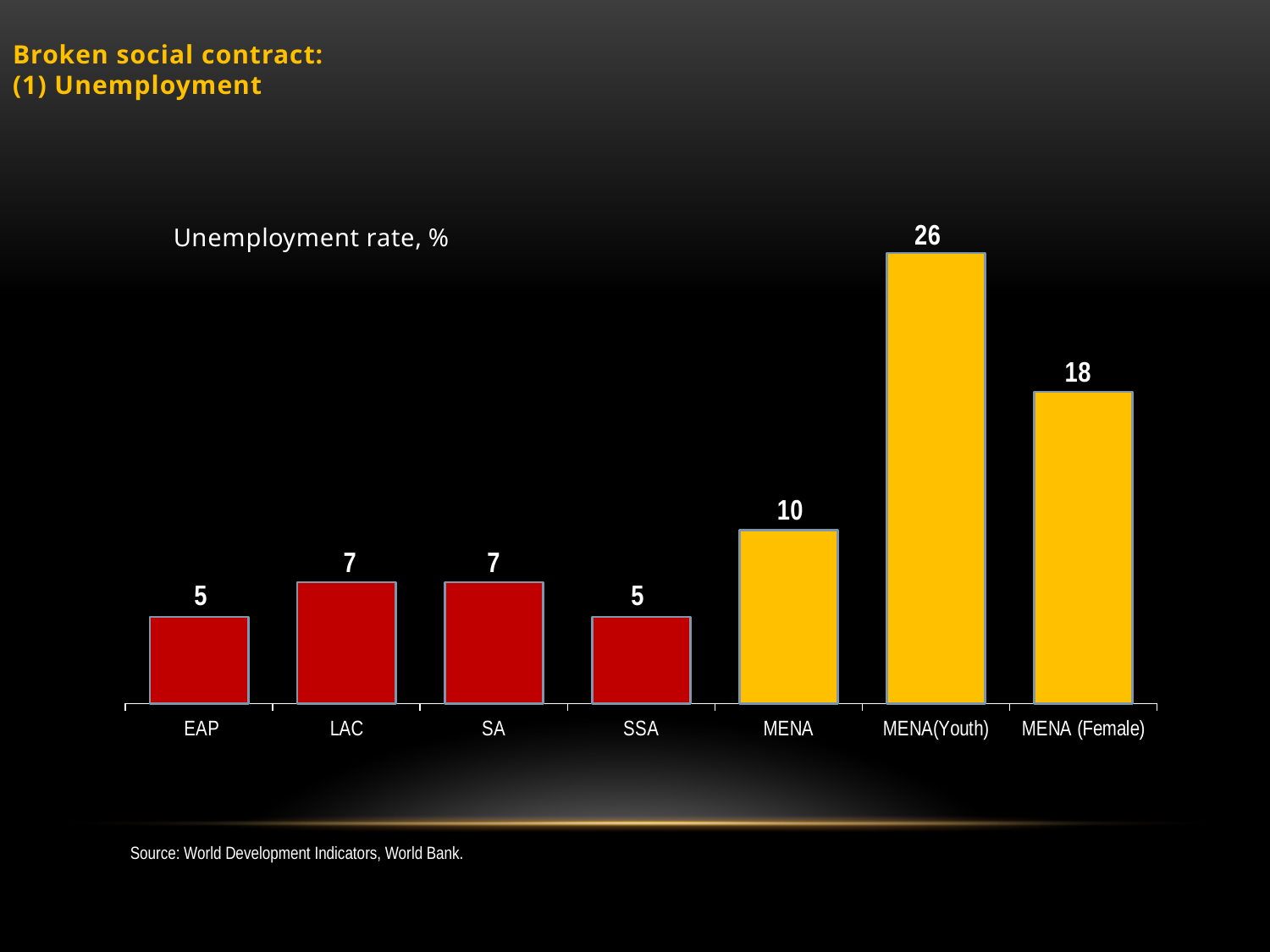
What is the unemployment rate for MENA (Female)? 18 What colour are the bars for the MENA categories? Yellow Which category has the highest unemployment rate? MENA(Youth) Which has a higher unemployment rate, MENA or SA? MENA What is the title of the chart? Unemployment rate, % What kind of chart is shown on the slide? Bar chart How many categories are shown on the chart? 7 What is the difference between the unemployment rates of MENA (Female) and LAC? 11 What is the difference between the unemployment rates of MENA(Youth) and MENA? 16 What is the unemployment rate for MENA(Youth)? 26 What is the unemployment rate for SSA? 5 Which has a higher unemployment rate, MENA (Female) or MENA(Youth)? MENA(Youth)